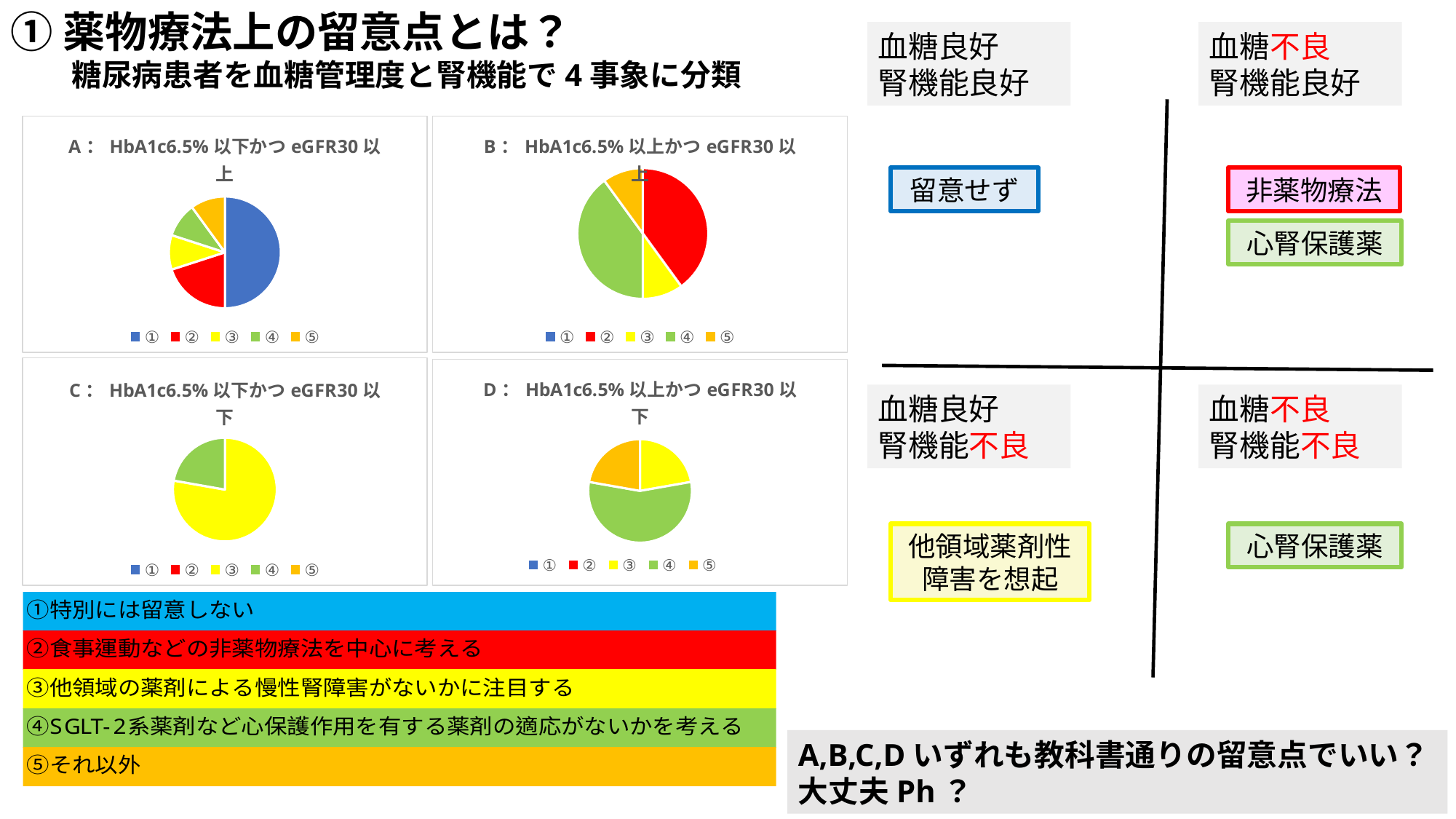
In chart A (HbA1c6.5%以下かつeGFR30以上), which slice is larger, ① or ②? ① In chart A (HbA1c6.5%以下かつeGFR30以上), which category has the largest slice? ① How many slices are shown in chart D (HbA1c6.5%以上かつeGFR30以下)? 3 How many slices are shown in chart C (HbA1c6.5%以下かつeGFR30以下)? 2 What colour represents category ③ in the legend of the pie charts? Yellow How many entries does the legend of chart B list? 5 In chart D (HbA1c6.5%以上かつeGFR30以下), which slice is larger, ④ or ⑤? ④ In chart C (HbA1c6.5%以下かつeGFR30以下), which category has the largest slice? ③ In chart D (HbA1c6.5%以上かつeGFR30以下), which category has the largest slice? ④ What kind of chart is chart A (HbA1c6.5%以下かつeGFR30以上)? Pie chart How many slices are shown in chart A (HbA1c6.5%以下かつeGFR30以上)? 5 In chart C (HbA1c6.5%以下かつeGFR30以下), which category has the smallest slice? ④